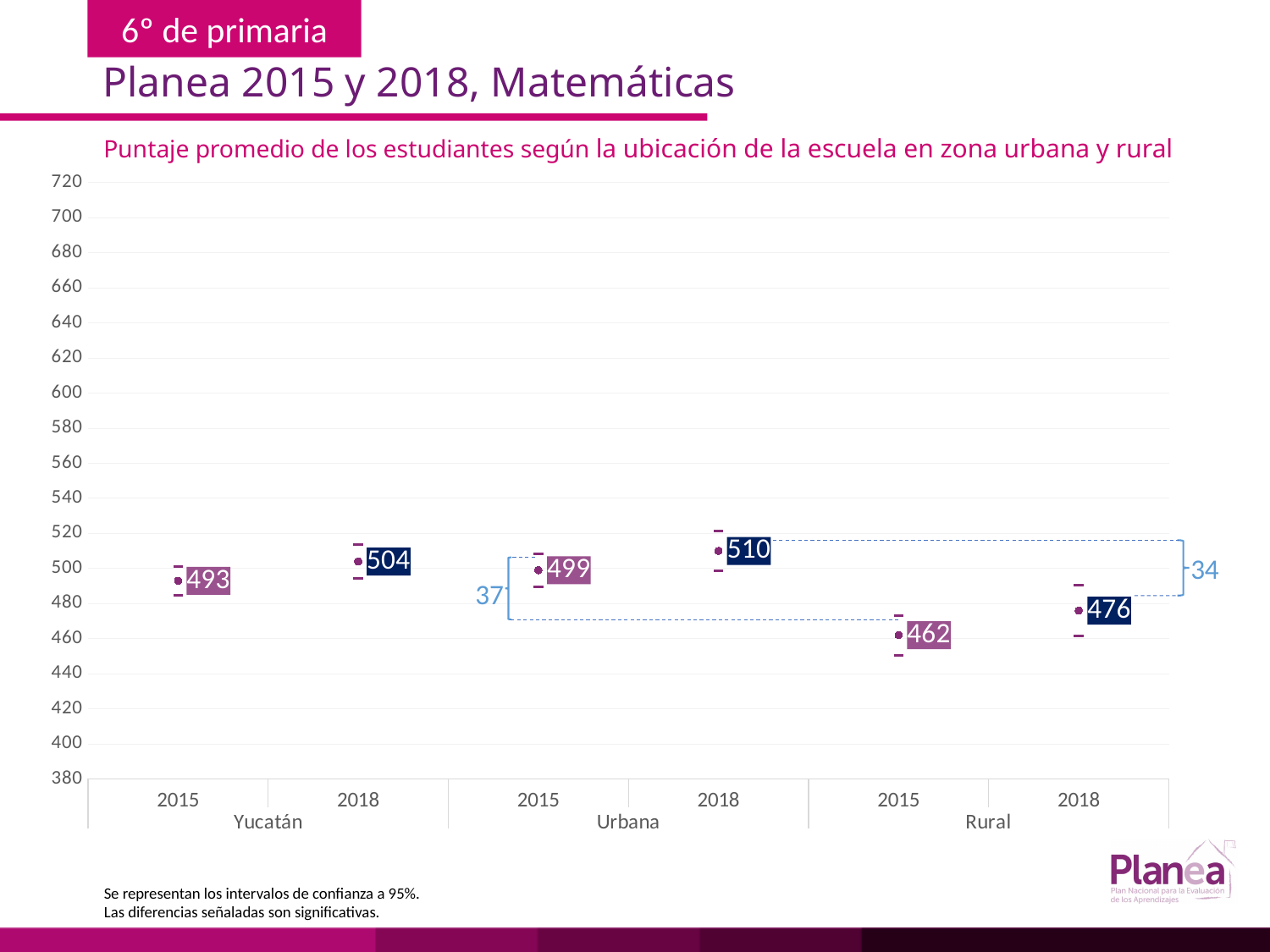
Which group and year has the highest average score? Urbana 2018 What is the average score for Yucatán in 2015? 493 Did the Rural score rise or fall from 2015 to 2018? rise What is the difference between the Urbana and Rural scores in 2018? 34 Which is larger, the Yucatán 2018 score or the Urbana 2015 score? Yucatán 2018 What is the difference between the Urbana and Rural scores in 2015? 37 Which group and year has the lowest average score? Rural 2015 How many data points are plotted on the chart? 6 By how many points did the Yucatán score change from 2015 to 2018? 11 What is the average score for Urbana in 2018? 510 What is the average score for Rural in 2018? 476 What is the average score for Rural in 2015? 462